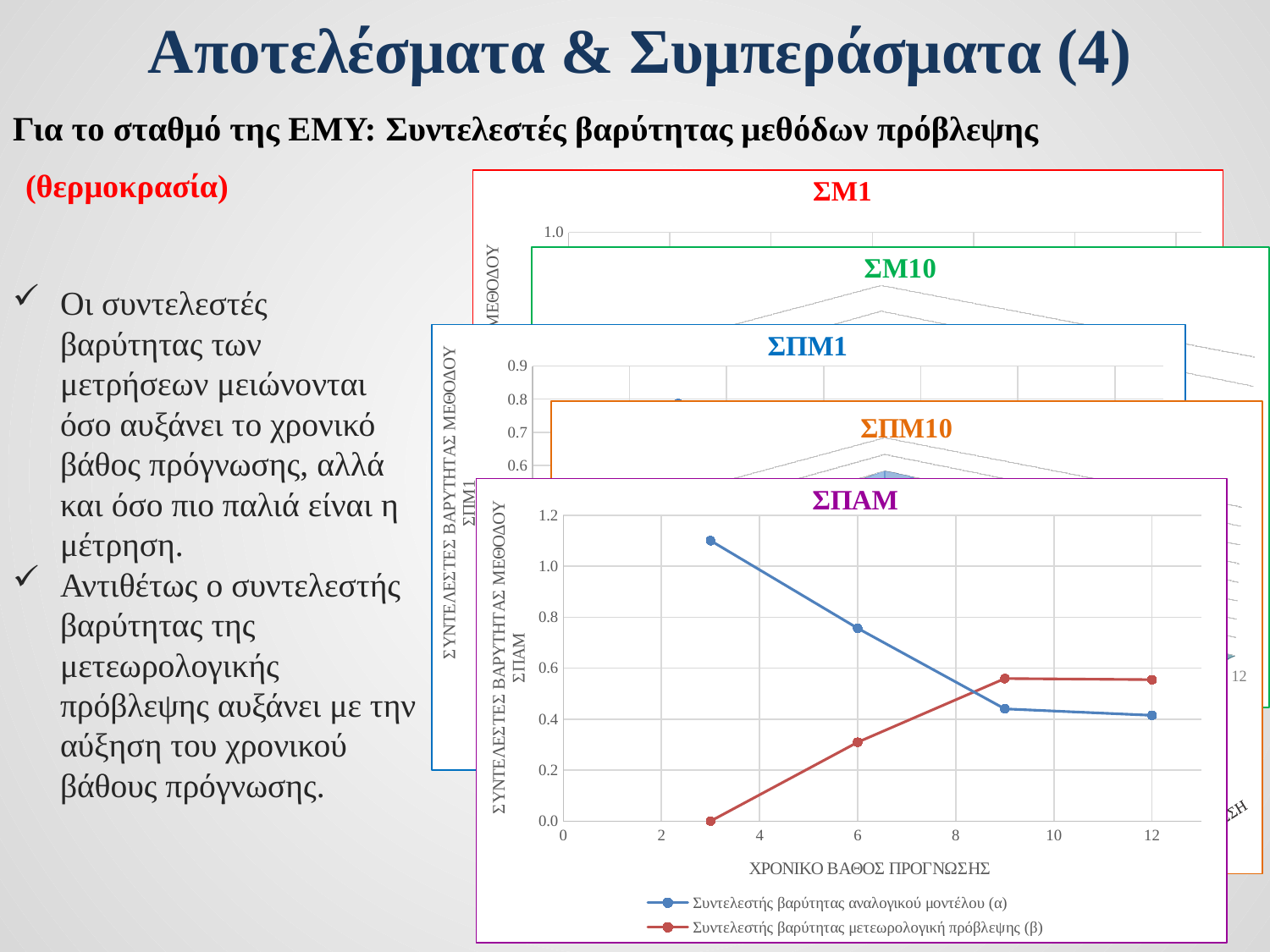
In the ΣΠΑΜ chart, is the value of Συντελεστής βαρύτητας μετεωρολογικής πρόβλεψης (β) at ΧΡΟΝΙΚΟ ΒΑΘΟΣ ΠΡΟΓΝΩΣΗΣ 6 greater or less than 0.4? less In the ΣΠΑΜ chart, at ΧΡΟΝΙΚΟ ΒΑΘΟΣ ΠΡΟΓΝΩΣΗΣ 12, which series has the larger value? Συντελεστής βαρύτητας μετεωρολογικής πρόβλεψης (β) In the ΣΠΑΜ chart, at which ΧΡΟΝΙΚΟ ΒΑΘΟΣ ΠΡΟΓΝΩΣΗΣ is Συντελεστής βαρύτητας μετεωρολογικής πρόβλεψης (β) lowest? 3 In the ΣΠΑΜ chart, what kind of chart is shown? line chart In the ΣΠΑΜ chart, what is the title of the x axis? ΧΡΟΝΙΚΟ ΒΑΘΟΣ ΠΡΟΓΝΩΣΗΣ In the ΣΠΑΜ chart, how many data points does the series Συντελεστής βαρύτητας αναλογικού μοντέλου (α) have? 4 In the ΣΠΑΜ chart, at ΧΡΟΝΙΚΟ ΒΑΘΟΣ ΠΡΟΓΝΩΣΗΣ 6, which series has the larger value? Συντελεστής βαρύτητας αναλογικού μοντέλου (α) In the ΣΠΑΜ chart, how many series does the legend list? 2 In the ΣΠΑΜ chart, is the value of Συντελεστής βαρύτητας αναλογικού μοντέλου (α) at ΧΡΟΝΙΚΟ ΒΑΘΟΣ ΠΡΟΓΝΩΣΗΣ 9 greater or less than 0.6? less In the ΣΠΑΜ chart, does the series Συντελεστής βαρύτητας αναλογικού μοντέλου (α) rise or fall as ΧΡΟΝΙΚΟ ΒΑΘΟΣ ΠΡΟΓΝΩΣΗΣ increases? fall In the ΣΠΑΜ chart, is the value of Συντελεστής βαρύτητας αναλογικού μοντέλου (α) at ΧΡΟΝΙΚΟ ΒΑΘΟΣ ΠΡΟΓΝΩΣΗΣ 3 greater or less than 1.0? greater In the ΣΠΑΜ chart, does the series Συντελεστής βαρύτητας μετεωρολογικής πρόβλεψης (β) rise or fall as ΧΡΟΝΙΚΟ ΒΑΘΟΣ ΠΡΟΓΝΩΣΗΣ increases? rise